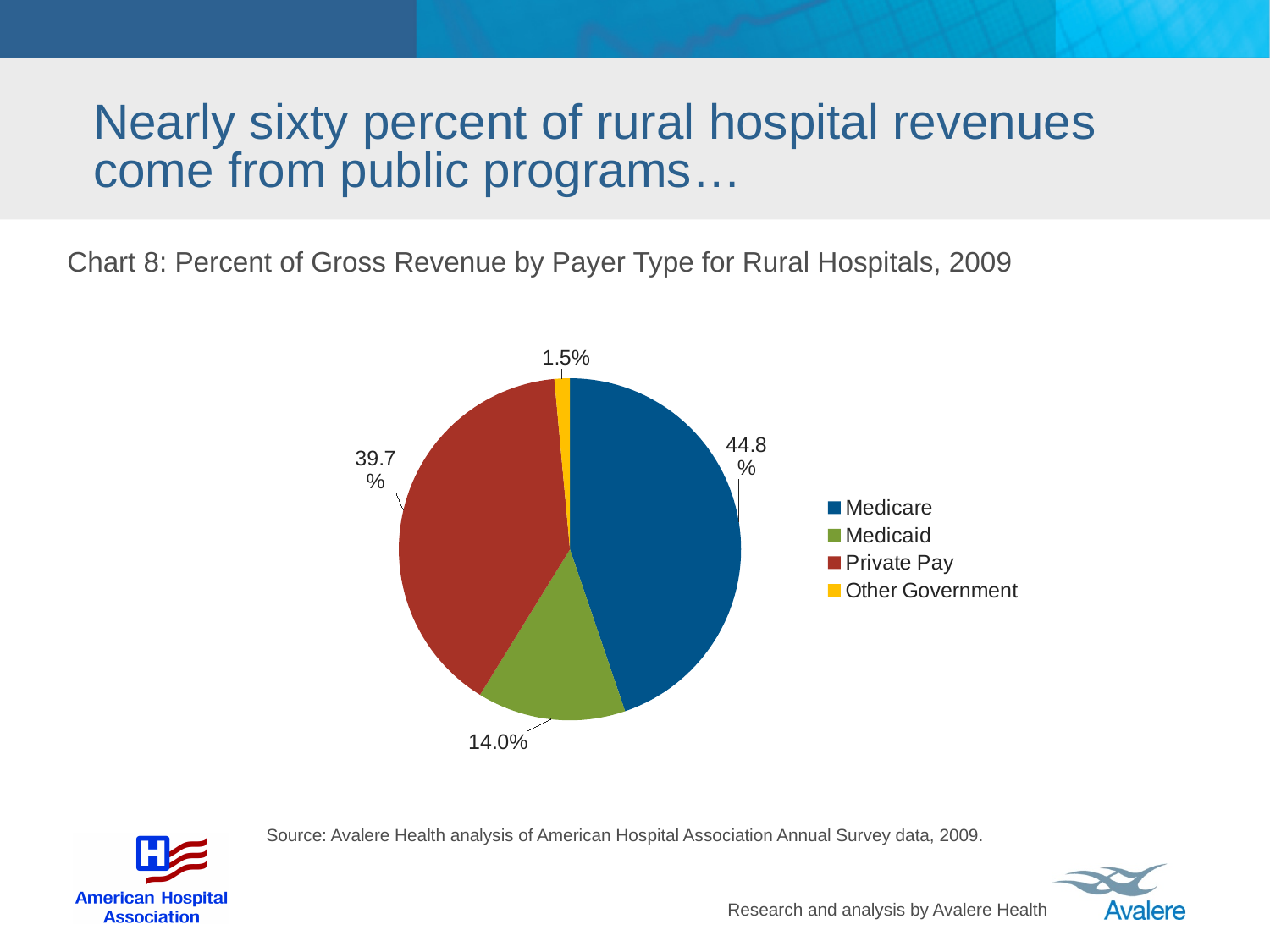
What colour represents Private Pay in the pie chart? Red Which payer type accounts for the smallest share of gross revenue? Other Government What percent of gross revenue comes from Private Pay? 39.7% What kind of chart is shown on the slide? Pie chart What is the combined share of Medicare and Medicaid? 58.8% What percent of gross revenue comes from Medicare? 44.8% Which payer type accounts for the largest share of gross revenue? Medicare What percent of gross revenue comes from Other Government? 1.5% What is the difference in percentage points between the Medicare and Private Pay shares? 5.1 How many payer types are shown in the pie chart? 4 Which is larger, the Medicaid share or the Private Pay share? Private Pay What percent of gross revenue comes from Medicaid? 14.0%